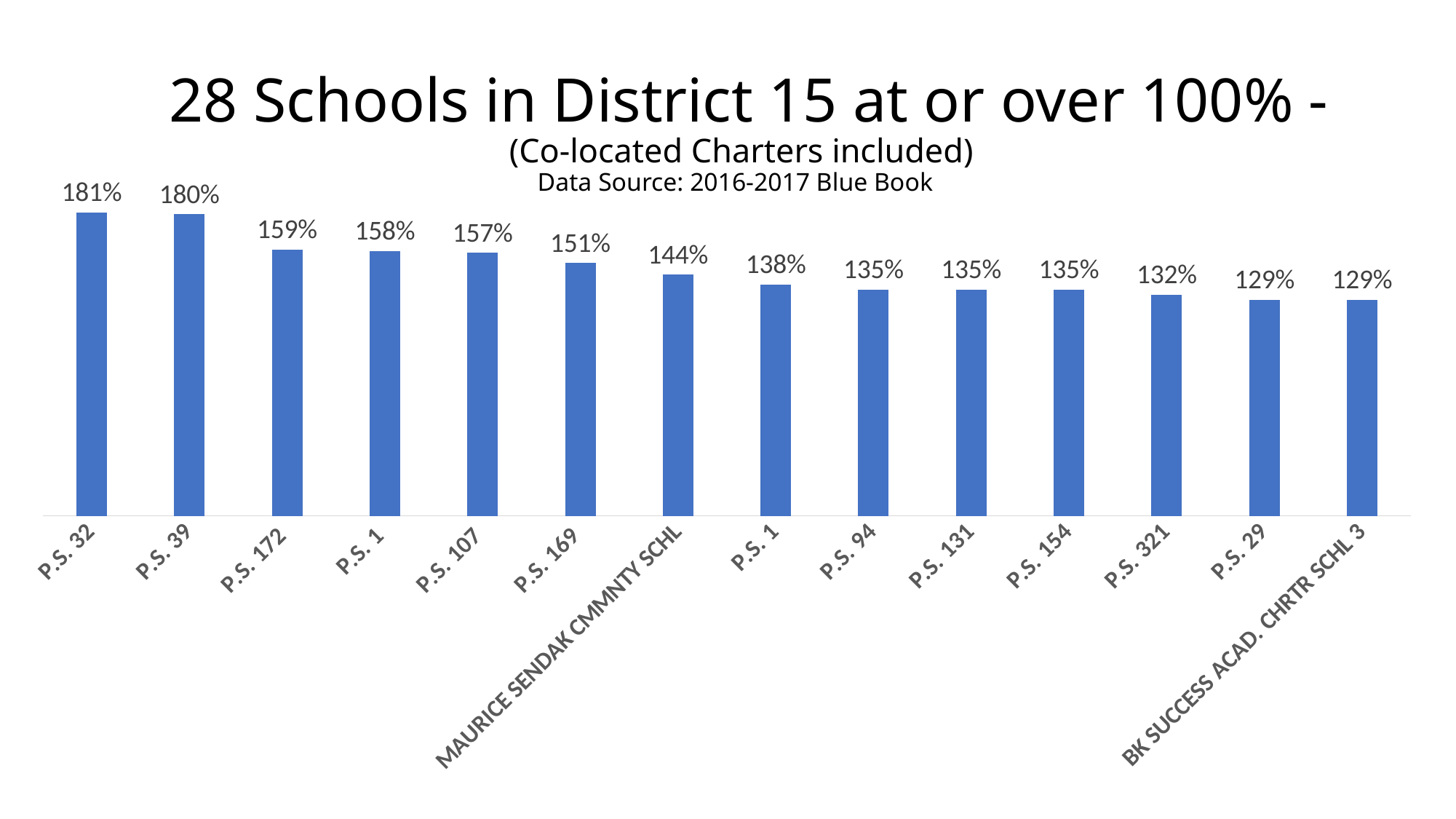
What is the value shown for P.S. 321? 132% What is the value shown for P.S. 32? 181% What is the difference between the values for P.S. 107 and P.S. 94? 22% How many schools (bars) are shown on the chart? 14 What is the value shown for P.S. 172? 159% What is the difference between the values for P.S. 32 and P.S. 39? 1% What kind of chart is shown on the slide? Bar chart What is the value shown for MAURICE SENDAK CMMNTY SCHL? 144% Which has a larger value, P.S. 169 or P.S. 29? P.S. 169 What is the lowest value shown on the chart? 129% What is the value shown for BK SUCCESS ACAD. CHRTR SCHL 3? 129% Which school has the highest value on the chart? P.S. 32